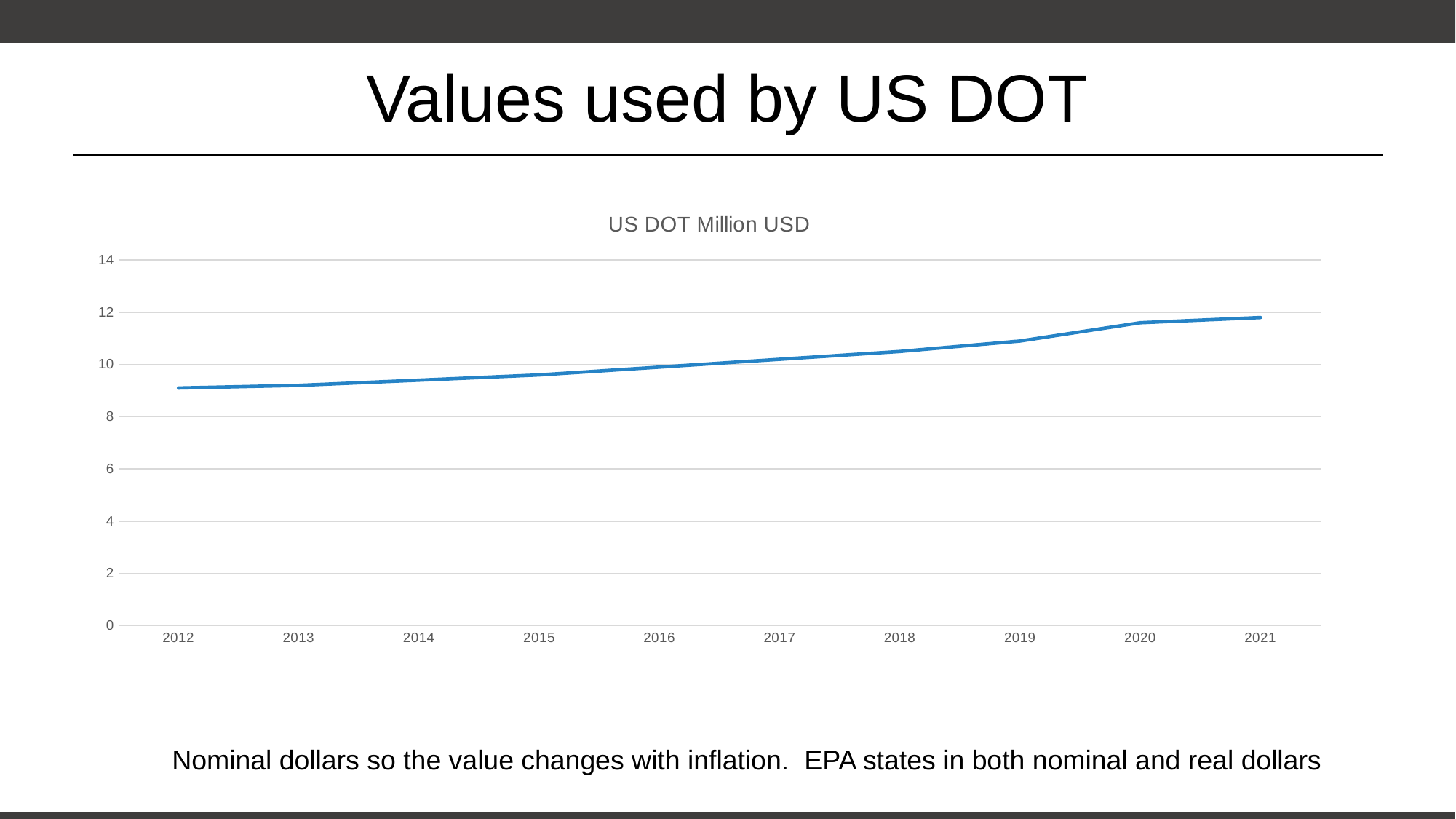
How many years are plotted along the x axis of the chart? 10 Which year has the larger value, 2015 or 2020? 2020 Which year has the highest value on the chart? 2021 Do the values rise or fall from 2012 to 2021? rise Is the value for 2021 greater or less than 10? greater Which year has the larger value, 2012 or 2021? 2021 Is the value for 2012 greater or less than 10? less Is the value for 2019 greater or less than 10? greater What kind of chart is shown on the slide? line chart What is the title of the chart? US DOT Million USD Which year has the lowest value on the chart? 2012